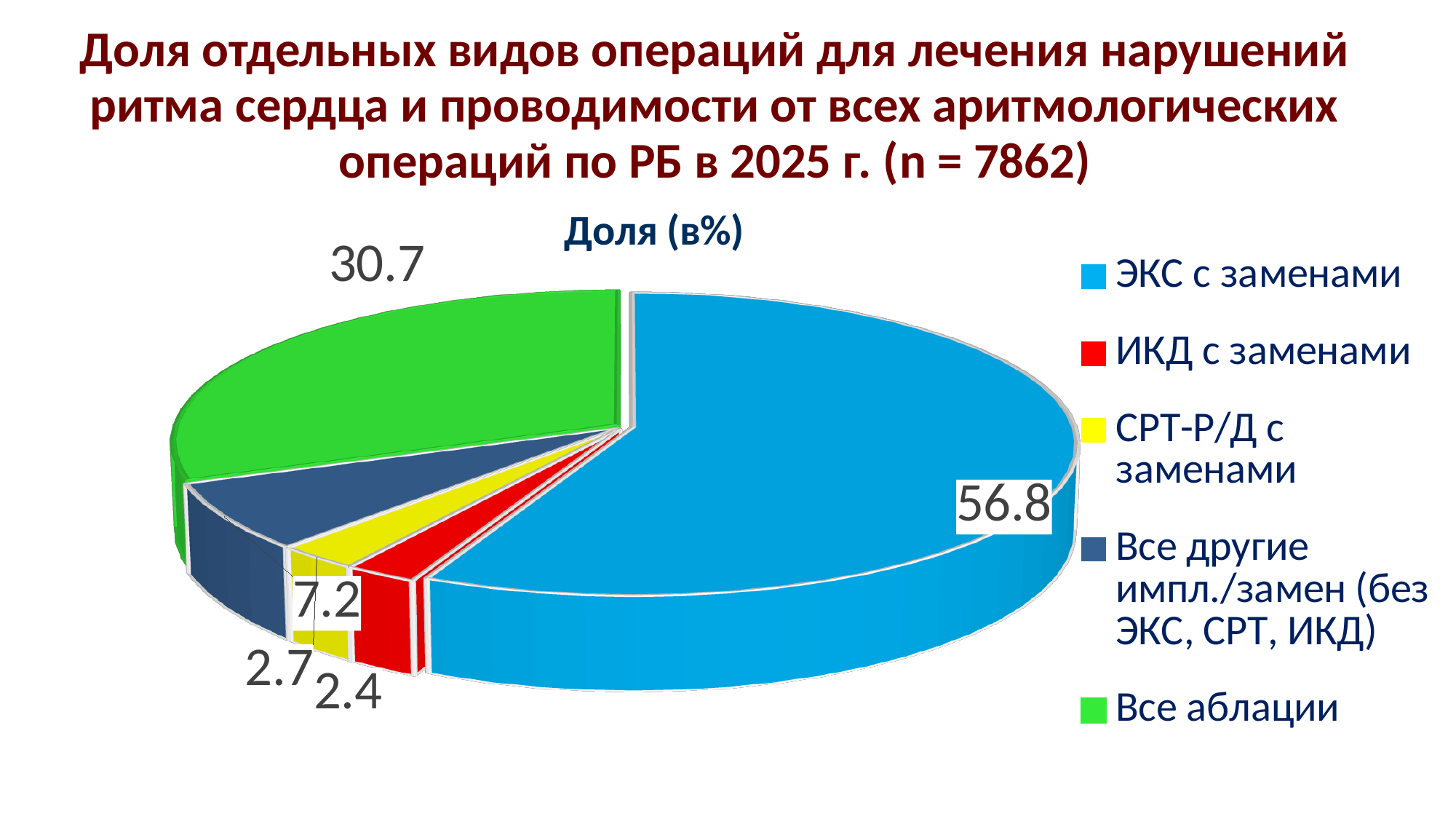
What is the value for Все аблации? 30.7 Which is larger, the value for Все аблации or the value for Все другие импл./замен (без ЭКС, СРТ, ИКД)? Все аблации Which category has the smallest share of the pie? ИКД с заменами What is the value for Все другие импл./замен (без ЭКС, СРТ, ИКД)? 7.2 What colour is the slice for Все аблации? green Which category has the largest share of the pie? ЭКС с заменами What is the value for СРТ-Р/Д с заменами? 2.7 What is the value for ЭКС с заменами? 56.8 How many slices does the pie chart have? 5 What kind of chart is shown on the slide? pie chart What is the difference between the values for ЭКС с заменами and Все аблации? 26.1 What is the value for ИКД с заменами? 2.4